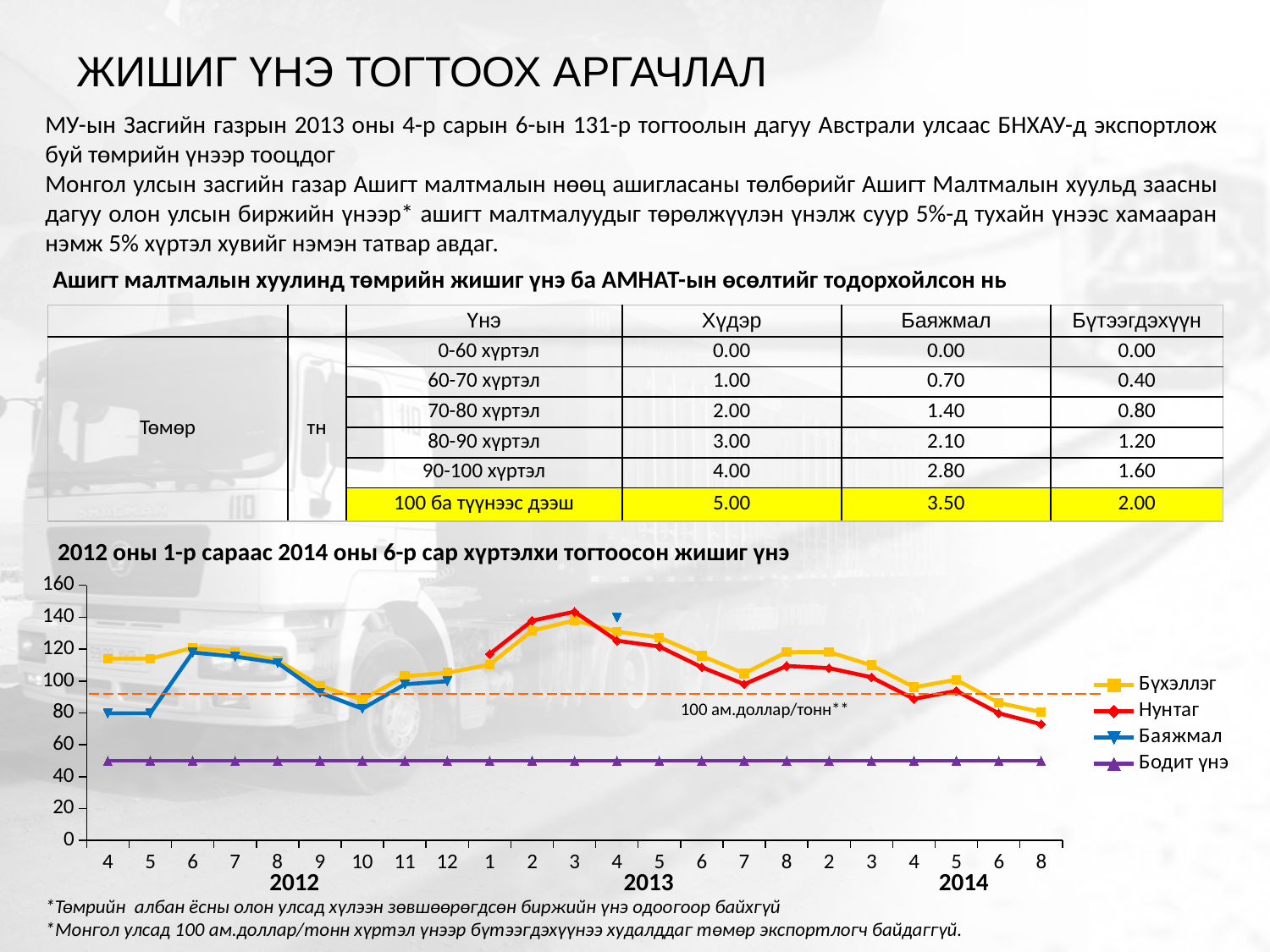
What kind of chart is shown on the slide? line chart At month 8 of 2014, which is larger: Нунтаг or Бодит үнэ? Нунтаг Is the value of Бодит үнэ greater or less than 60? less What label is written next to the dashed horizontal line on the chart? 100 ам.доллар/тонн** Which series are listed in the chart legend? Бүхэллэг, Нунтаг, Баяжмал, Бодит үнэ Is the value for Бүхэллэг at month 3 of 2013 greater or less than 120? greater How many month points are shown along the x axis of the chart? 23 At month 4 of 2012, which series has the highest value? Бүхэллэг Is the value for Баяжмал at month 6 of 2012 greater or less than 100? greater Does the Нунтаг series rise or fall from month 3 of 2013 to month 8 of 2014? fall How many series does the chart legend list? 4